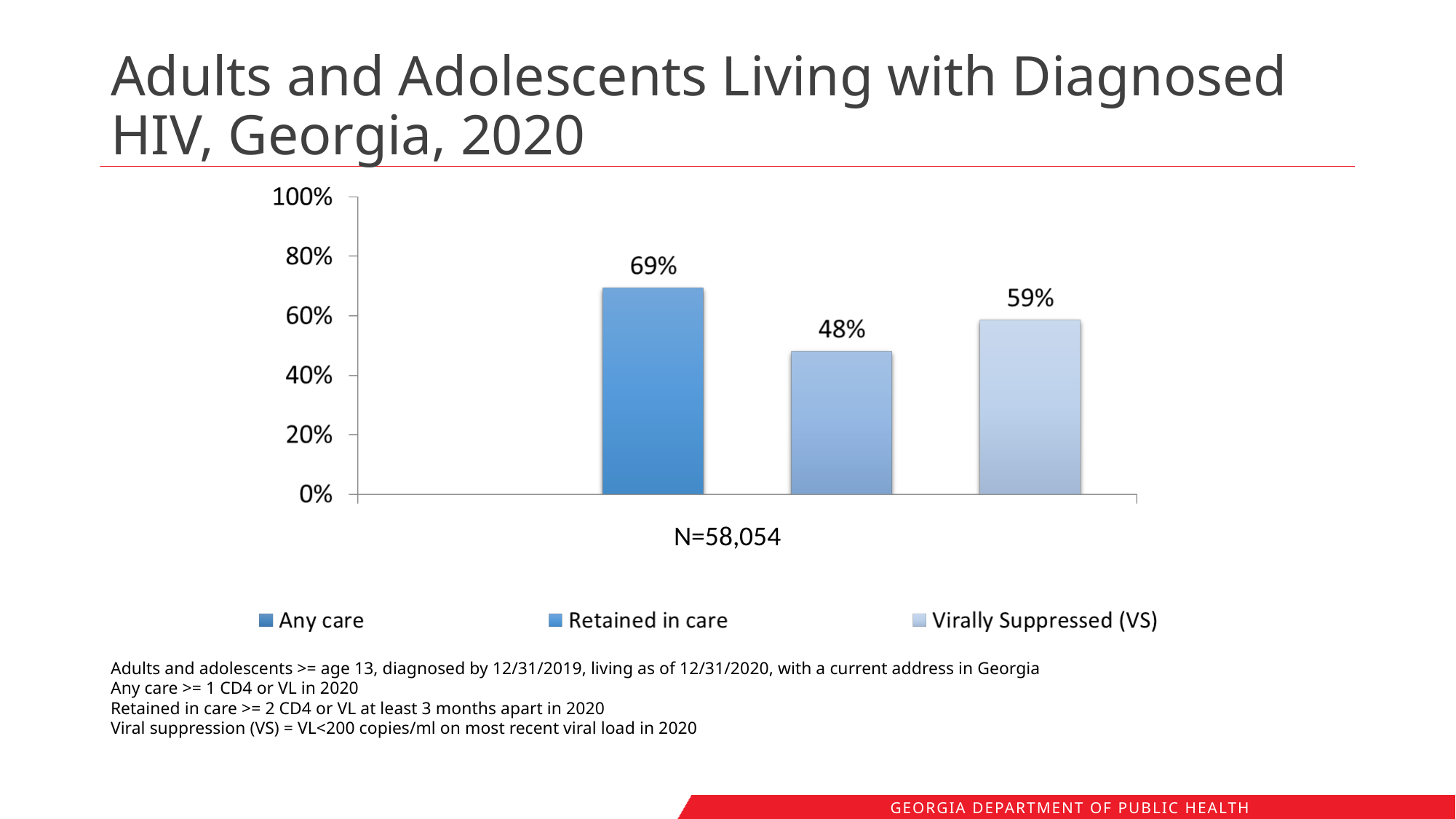
What percentage of adults and adolescents living with diagnosed HIV received any care? 69% What is the difference in percentage points between Any care and Retained in care? 21 Which is larger, the percentage for Virally Suppressed (VS) or for Retained in care? Virally Suppressed (VS) How many bars are shown in the chart? 3 What is the difference in percentage points between Virally Suppressed (VS) and Retained in care? 11 What percentage were retained in care? 48% Which category has the highest percentage? Any care Which category has the lowest percentage? Retained in care What kind of chart is shown on the slide? Bar chart Is the value for Retained in care greater or less than 60%? less What percentage were virally suppressed (VS)? 59% What is the N (population size) shown below the chart? N=58,054